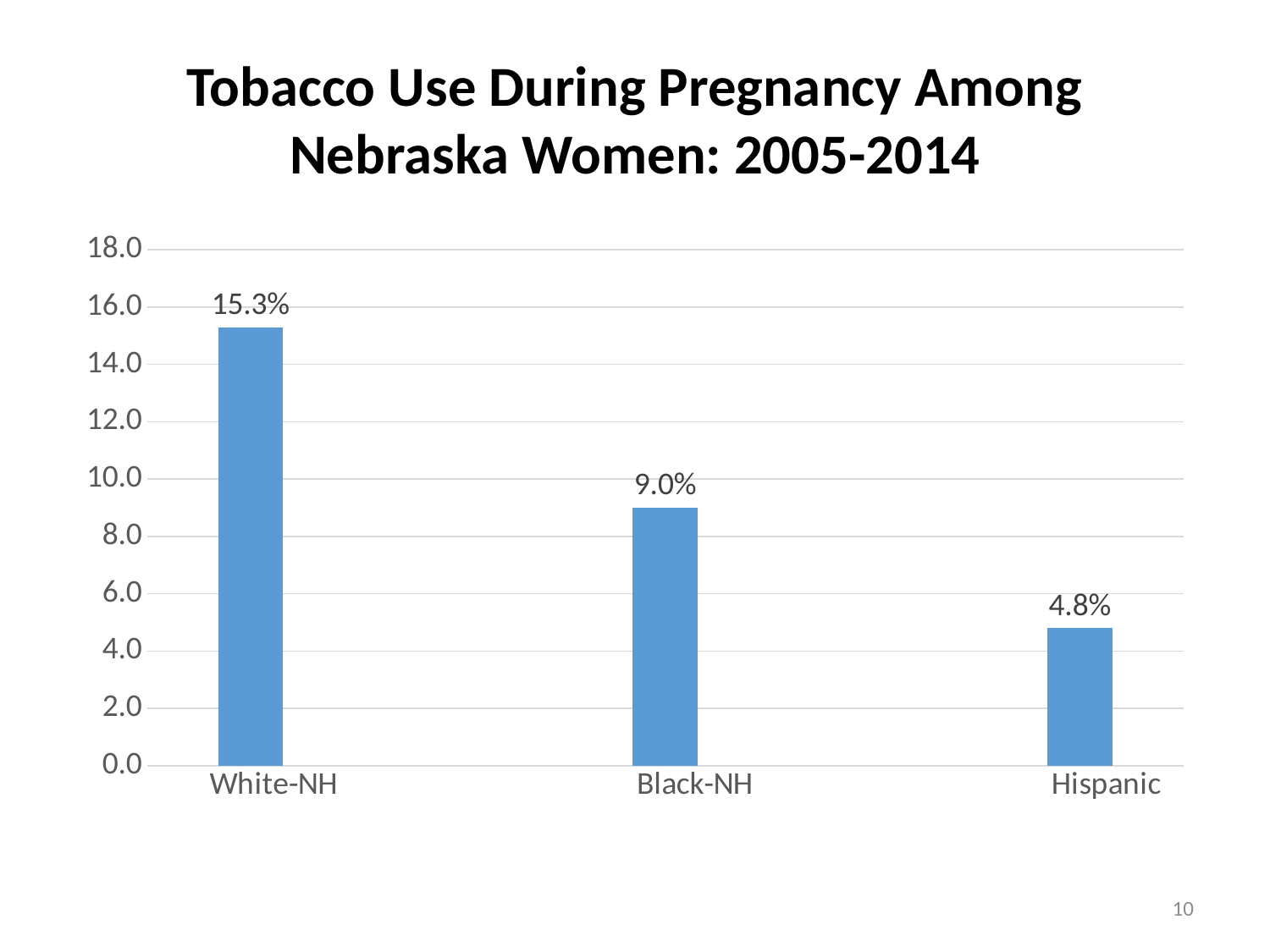
What is the value for Hispanic? 4.8% Which category has the highest value? White-NH Which is larger, the value for Black-NH or the value for Hispanic? Black-NH Is the value for White-NH greater or less than 14.0? greater What is the value for Black-NH? 9.0% What is the difference between the values for Black-NH and Hispanic? 4.2% How many categories are shown on the chart? 3 What is the title of the chart? Tobacco Use During Pregnancy Among Nebraska Women: 2005-2014 Which category has the lowest value? Hispanic What kind of chart is shown on the slide? bar chart What is the difference between the values for White-NH and Black-NH? 6.3% What is the value for White-NH? 15.3%